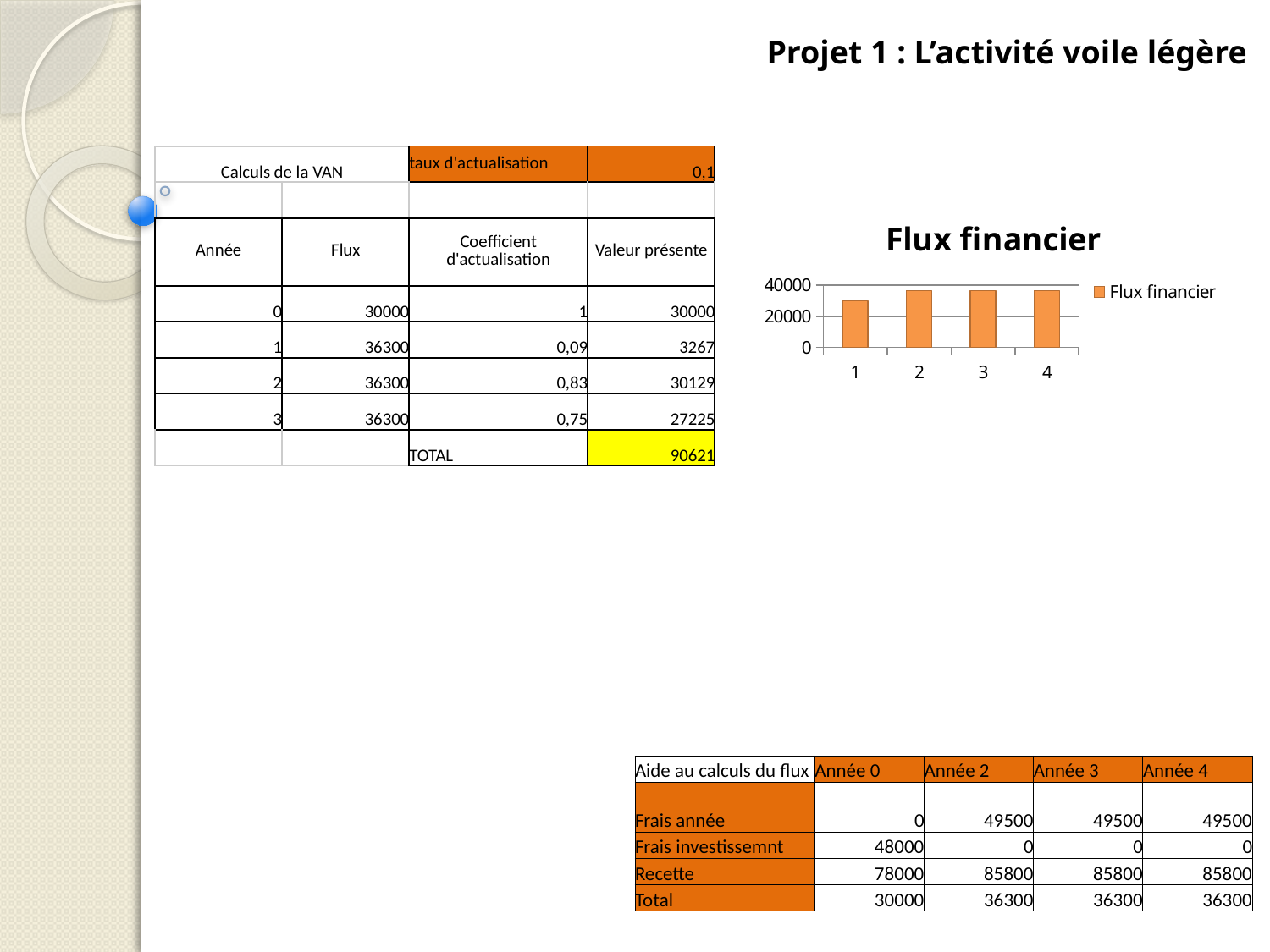
In the "Flux financier" chart, is the value for category 1 greater or less than 20000? greater In the "Flux financier" chart, which bar is taller, category 3 or category 1? 3 In the "Flux financier" chart, which category has the lowest bar? 1 How many bars are plotted in the "Flux financier" chart? 4 What is the highest value shown on the vertical axis of the "Flux financier" chart? 40000 How many series does the legend of the "Flux financier" chart list? 1 In the "Flux financier" chart, is the value for category 2 greater or less than 40000? less In the "Flux financier" chart, is the value for category 4 greater or less than 20000? greater In the "Flux financier" chart, which bar is taller, category 1 or category 2? 2 What kind of chart is the "Flux financier" chart? bar chart What is the title of the chart on the slide? Flux financier What series name appears in the legend of the "Flux financier" chart? Flux financier